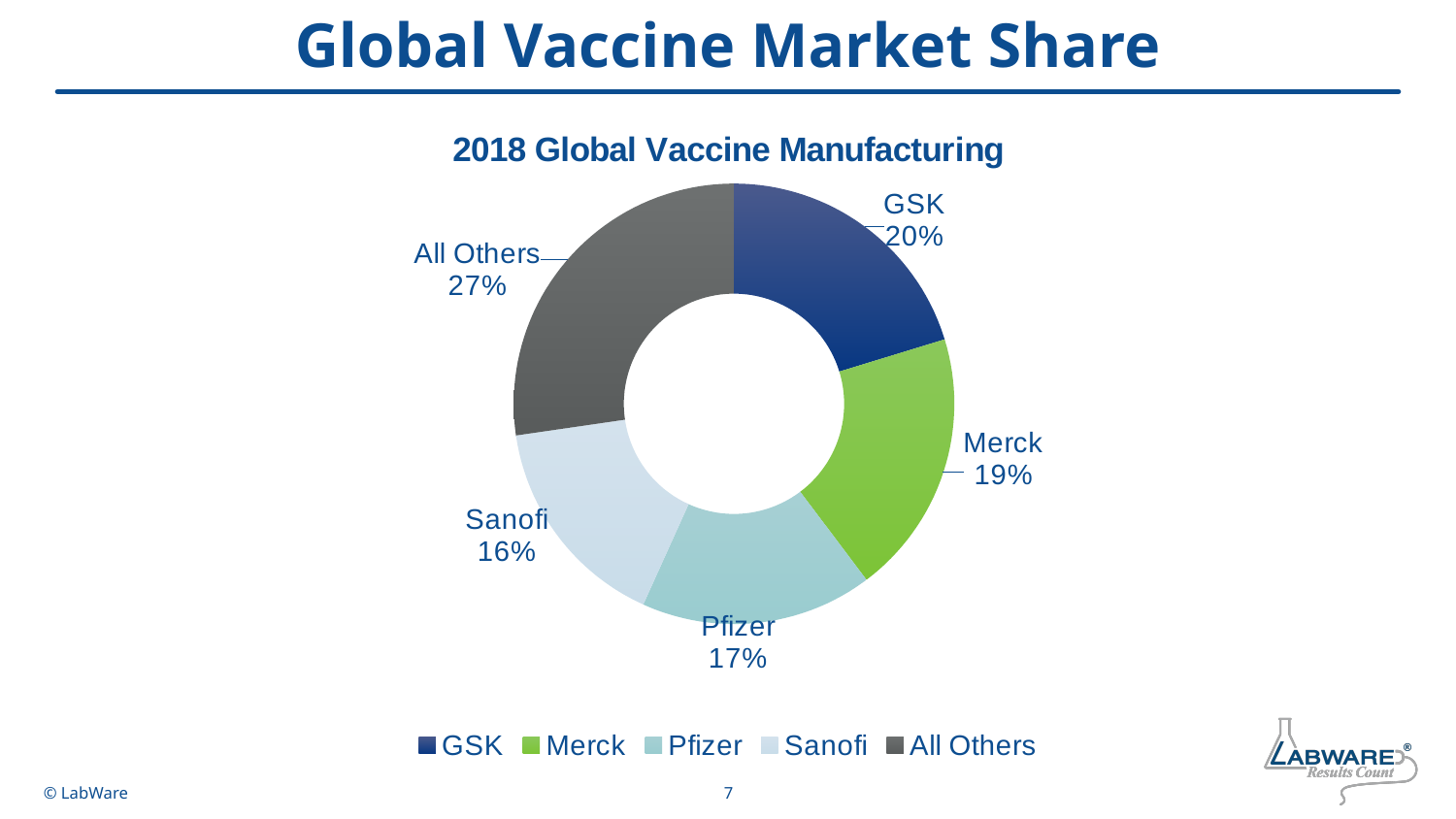
What share of 2018 global vaccine manufacturing does Merck hold? 19% Which slice of the pie chart is the largest? All Others What share of 2018 global vaccine manufacturing does Sanofi hold? 16% What is the difference between the All Others share and the GSK share? 7% What share of 2018 global vaccine manufacturing is attributed to All Others? 27% What share of 2018 global vaccine manufacturing does Pfizer hold? 17% What share of 2018 global vaccine manufacturing does GSK hold? 20% How many slices does the pie chart have? 5 What kind of chart is shown on the slide? Doughnut chart What is the title of the chart? 2018 Global Vaccine Manufacturing Which has a larger share, Pfizer or Sanofi? Pfizer Which named company has the smallest share in the chart? Sanofi